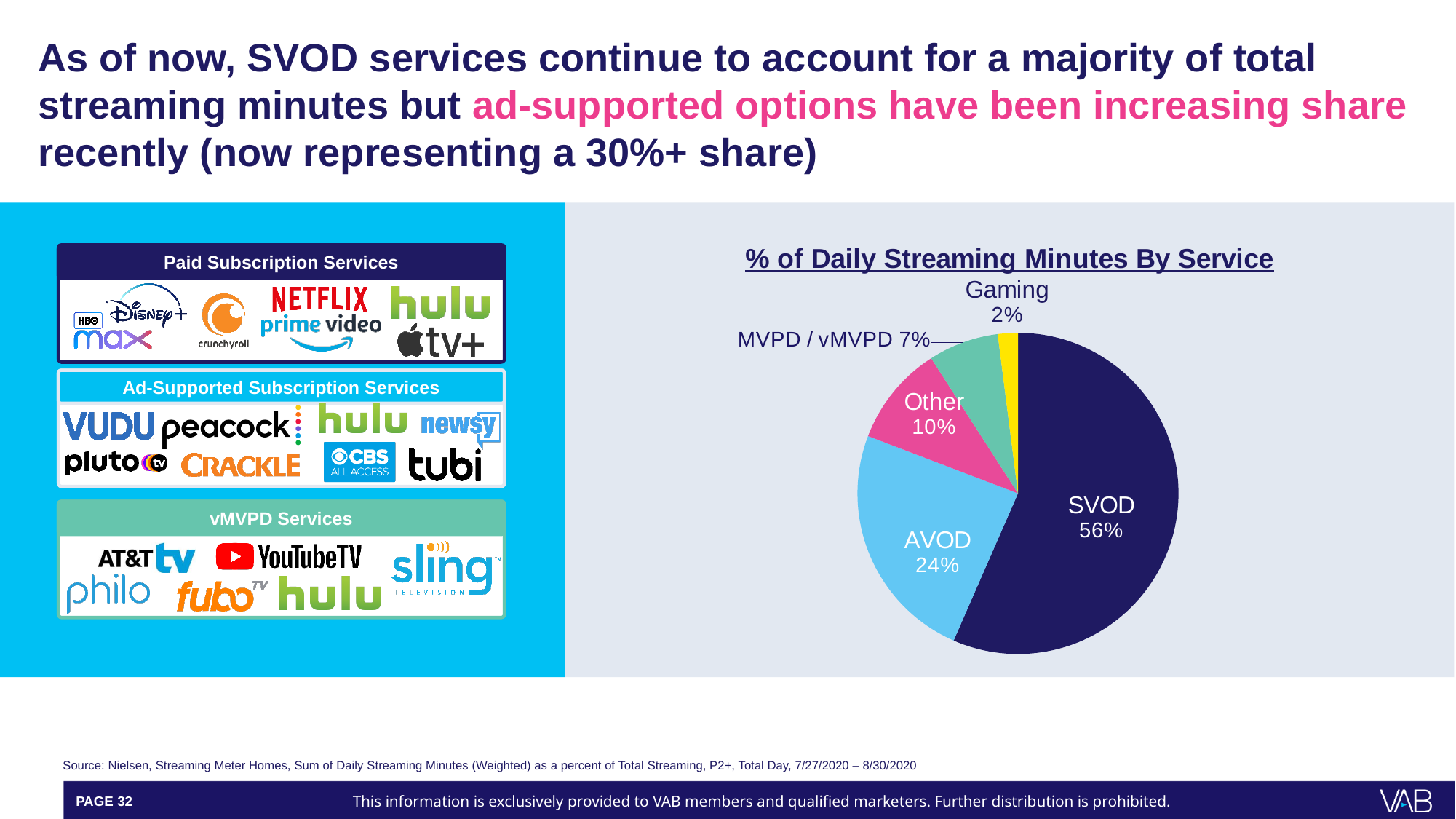
Which service category has the smallest share of daily streaming minutes? Gaming What is the difference in share between SVOD and AVOD? 32% What share of daily streaming minutes does MVPD / vMVPD account for? 7% What share of daily streaming minutes does SVOD account for? 56% Which service category has the largest share of daily streaming minutes? SVOD What share of daily streaming minutes does Gaming account for? 2% What share of daily streaming minutes does AVOD account for? 24% What kind of chart is used to show % of Daily Streaming Minutes By Service? Pie chart What share of daily streaming minutes does the Other category account for? 10% What is the title of the chart? % of Daily Streaming Minutes By Service Which has a larger share of daily streaming minutes, Other or MVPD / vMVPD? Other How many categories are shown in the pie chart? 5